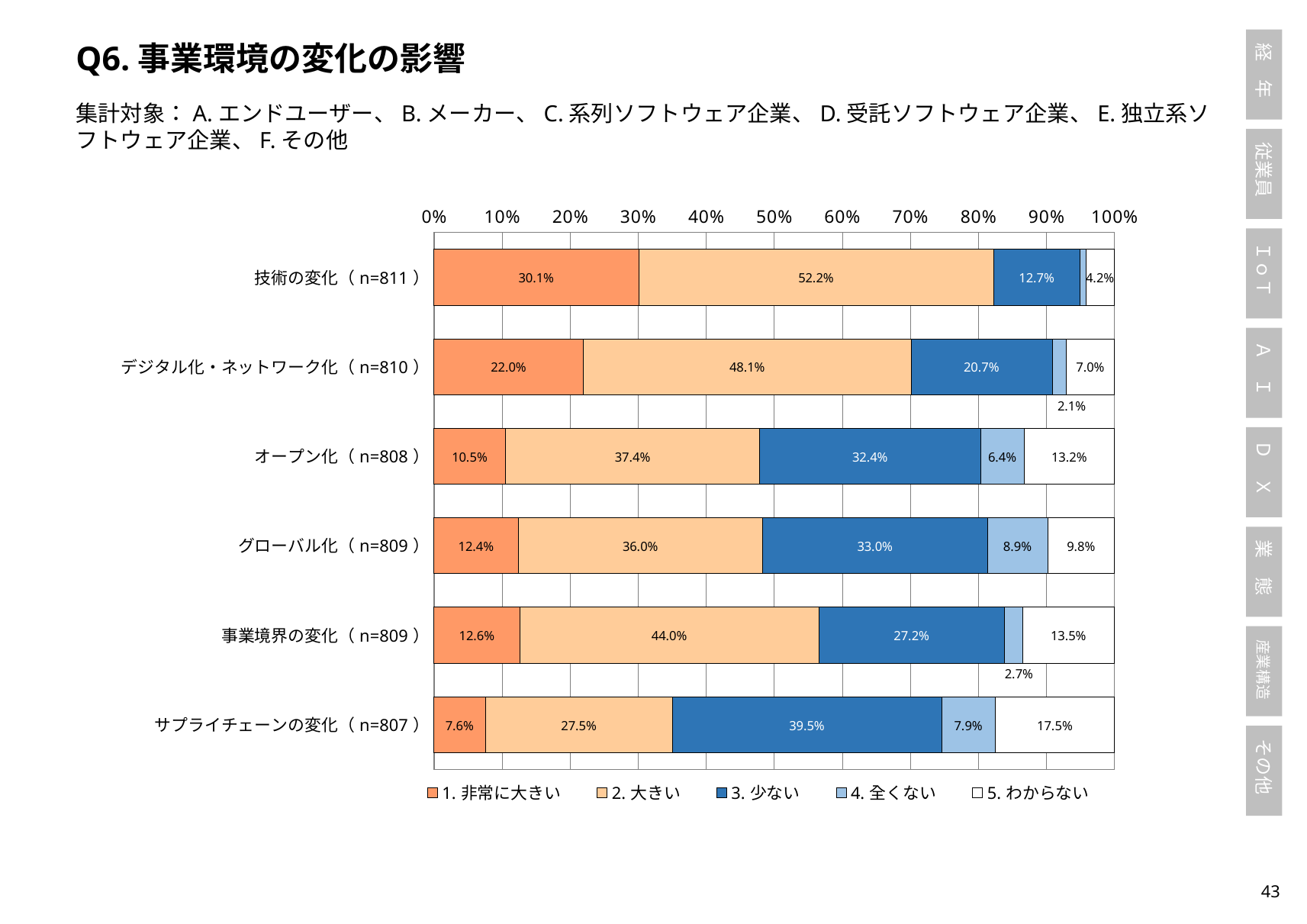
What kind of chart is shown on the slide? Stacked bar chart How many series does the legend list? 5 Which category has the lowest value for 「1. 非常に大きい」? サプライチェーンの変化 (n=807) What is the value of 「1. 非常に大きい」 for 技術の変化 (n=811)? 30.1% What is the value of 「3. 少ない」 for サプライチェーンの変化 (n=807)? 39.5% What is the value of 「4. 全くない」 for 事業境界の変化 (n=809)? 2.7% Which category has the highest value for 「2. 大きい」? 技術の変化 (n=811) How many categories are shown on the chart? 6 What is the value of 「5. わからない」 for オープン化 (n=808)? 13.2% Which legend entry is shown in dark blue? 3. 少ない Which is larger: the 「3. 少ない」 value for オープン化 (n=808) or for 事業境界の変化 (n=809)? オープン化 (n=808) What is the difference between the 「2. 大きい」 values for デジタル化・ネットワーク化 (n=810) and グローバル化 (n=809)? 12.1%